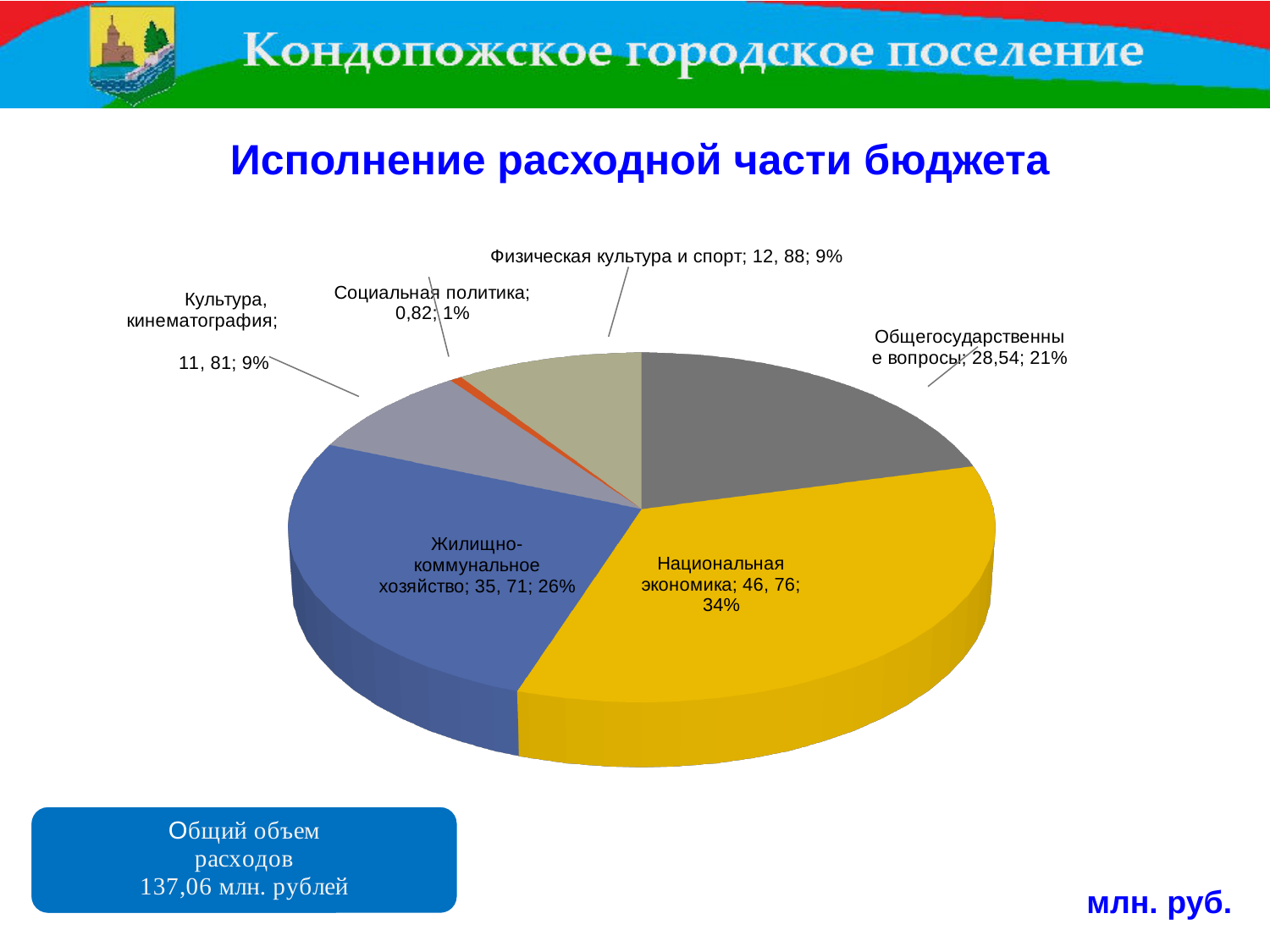
Which category has the largest share of the pie? Национальная экономика What is the value shown for Социальная политика? 0,82 What share of the pie does Национальная экономика have? 34% What kind of chart is shown on the slide? pie chart By how many percentage points does the share of Национальная экономика exceed that of Жилищно-коммунальное хозяйство? 8 What is the value shown for Общегосударственные вопросы? 28,54 Which is larger: the share for Общегосударственные вопросы or for Жилищно-коммунальное хозяйство? Жилищно-коммунальное хозяйство How many slices does the pie chart have? 6 Which category has the smallest share of the pie? Социальная политика What percentage is shown for Физическая культура и спорт? 9% What share of the pie does Жилищно-коммунальное хозяйство have? 26% What is the title of the chart? Исполнение расходной части бюджета